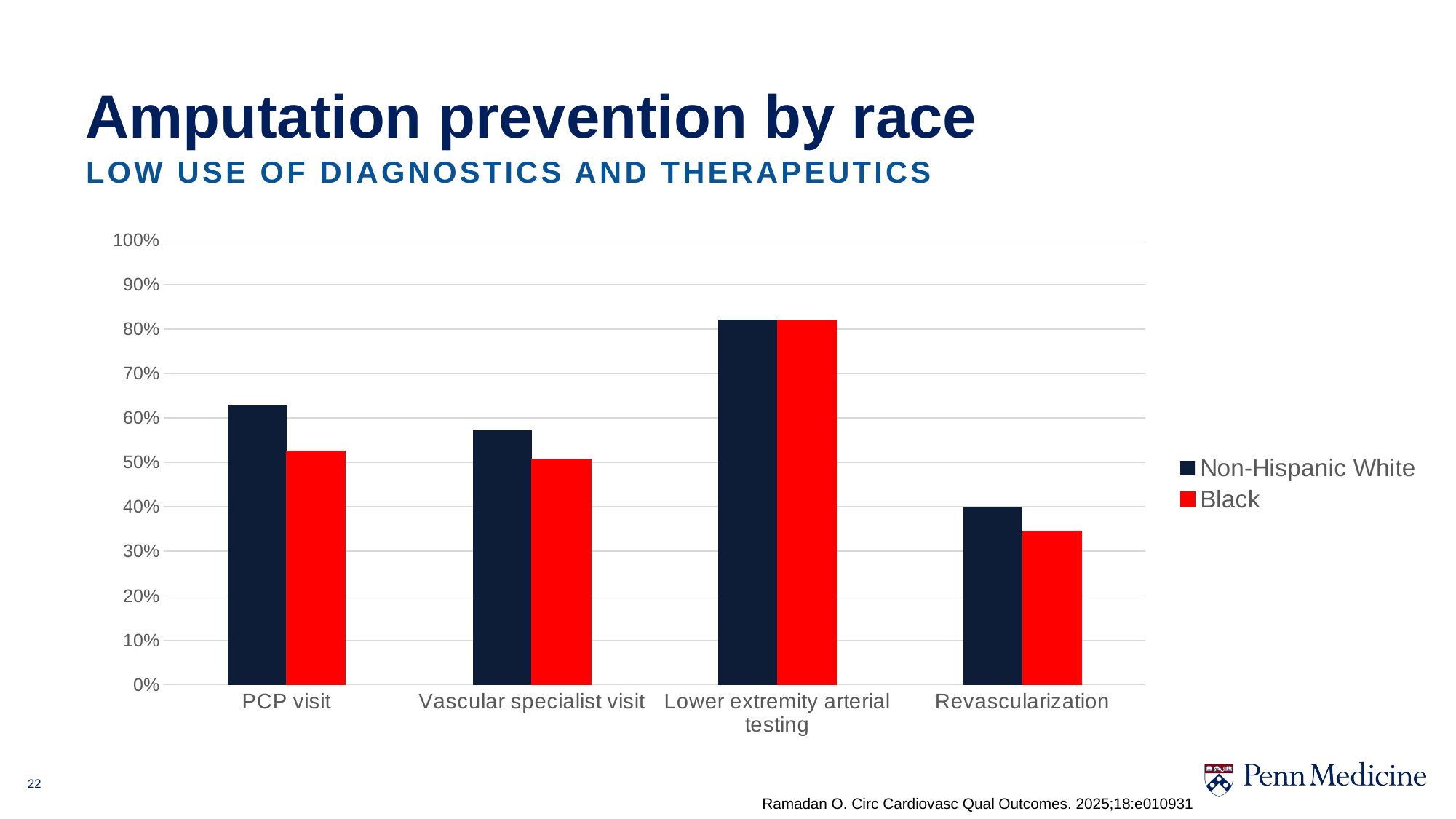
Is the Black value for Revascularization greater or less than 30%? greater How many series does the legend list? 2 Is the Black value for Lower extremity arterial testing greater or less than 70%? greater Which category has the lowest value for Black? Revascularization For PCP visit, which series has the larger value, Non-Hispanic White or Black? Non-Hispanic White Is the Non-Hispanic White value for Vascular specialist visit greater or less than 60%? less What colour represents the Black series in the legend? red Which category has the highest value for Non-Hispanic White? Lower extremity arterial testing For Revascularization, which series has the larger value, Non-Hispanic White or Black? Non-Hispanic White What kind of chart is shown on the slide? bar chart How many categories are shown on the x axis? 4